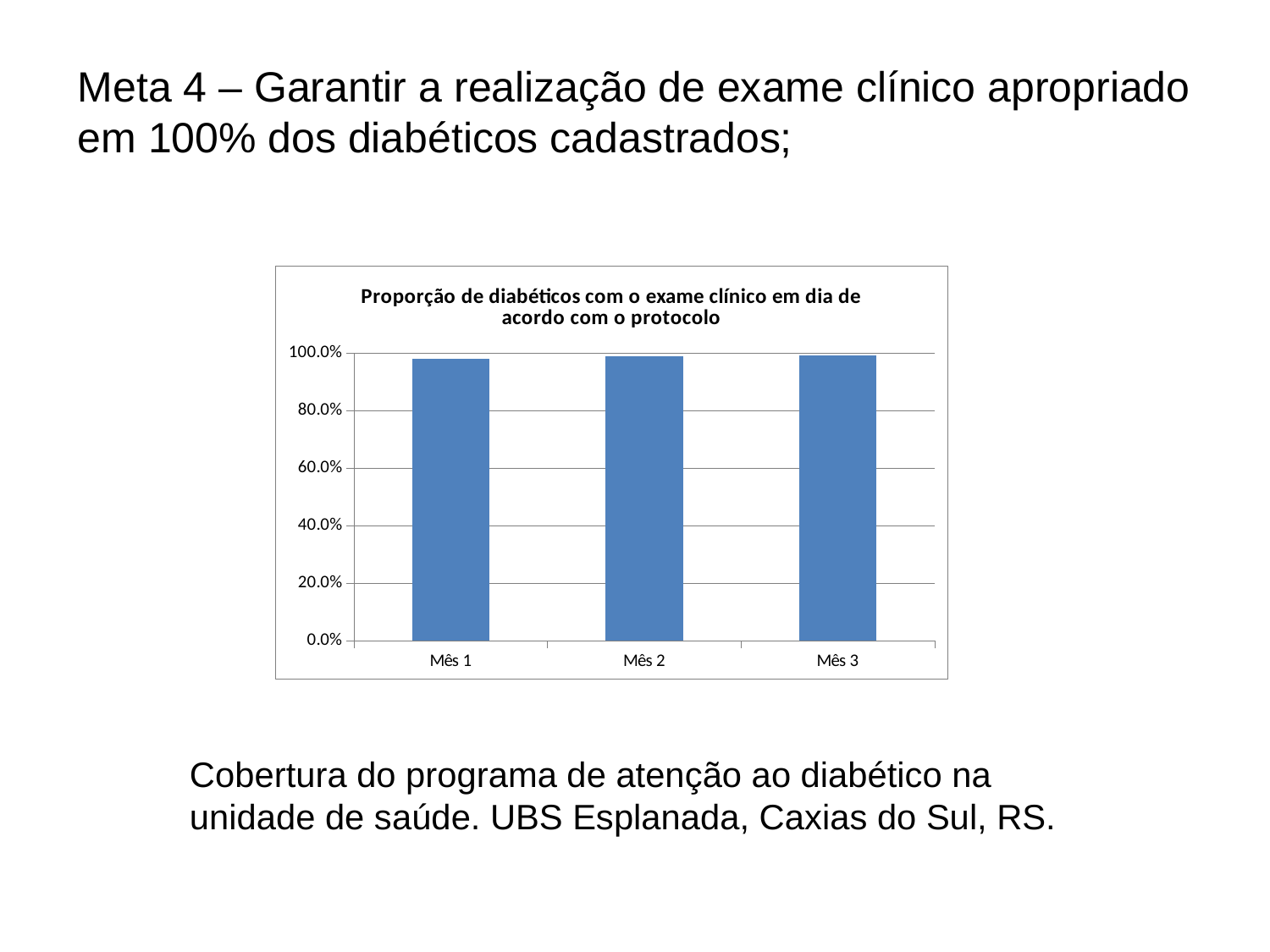
What is the title of the chart? Proporção de diabéticos com o exame clínico em dia de acordo com o protocolo Is the value for Mês 3 greater or less than 60.0%? greater Is the value for Mês 2 greater or less than 20.0%? greater How many categories (months) are plotted in the chart? 3 What kind of chart is shown on the slide? bar chart What is the highest value shown on the vertical axis of the chart? 100.0% Is the value for Mês 1 greater or less than 80.0%? greater What is the label of the first category on the x axis? Mês 1